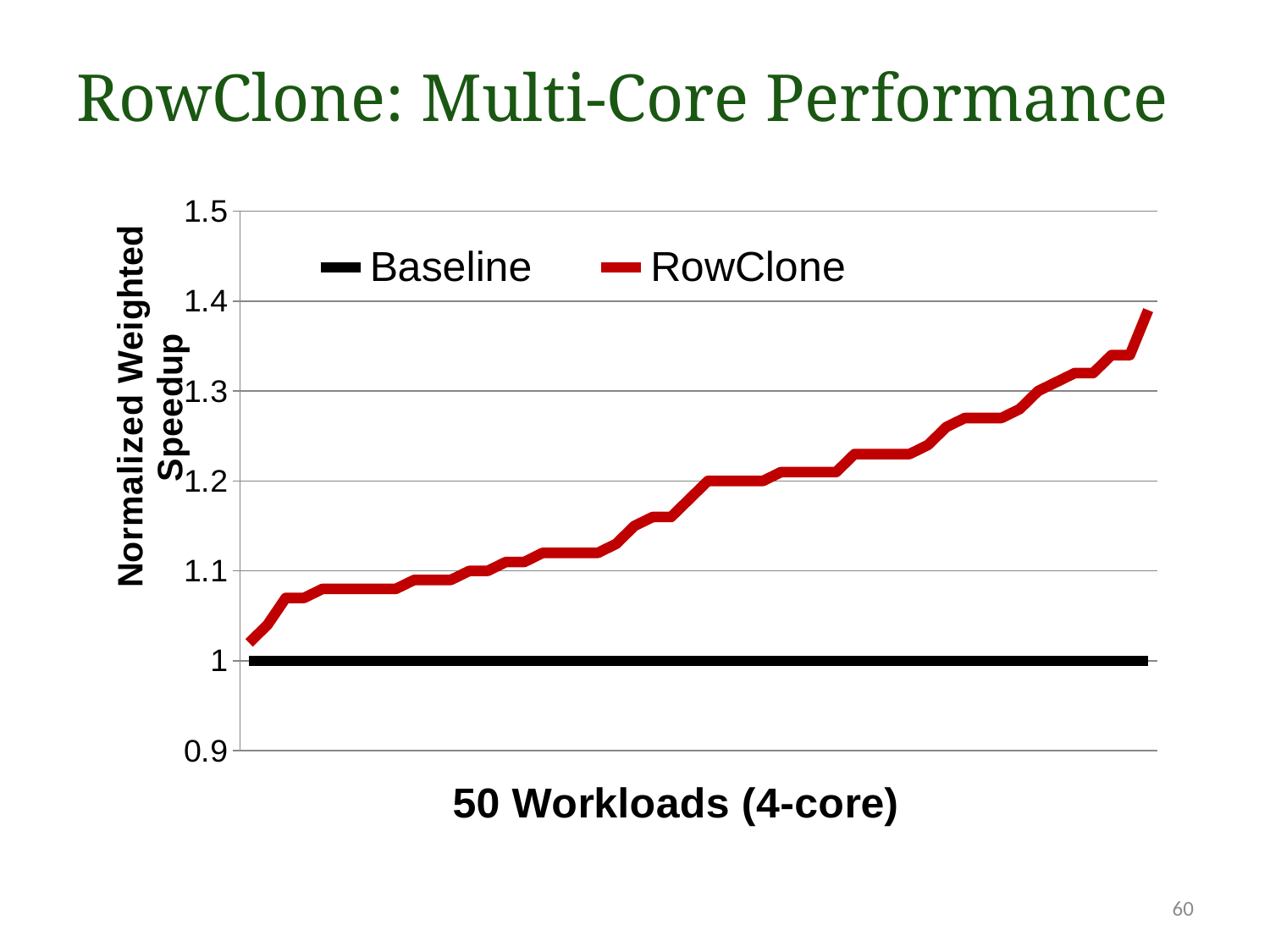
Is the lowest RowClone value greater or less than 1.1? less Is the Baseline value greater or less than 1.1? less How many workloads are plotted along the x axis? 50 Is the highest RowClone value greater or less than 1.5? less What is the y-axis title of the chart? Normalized Weighted Speedup Does the RowClone series rise or fall from left to right along the x axis? rise What are the two series named in the legend? Baseline and RowClone How many series does the legend list? 2 Which series has the higher normalized weighted speedup across the workloads, Baseline or RowClone? RowClone What is the normalized weighted speedup of the Baseline series? 1 What kind of chart is shown on the slide? line chart